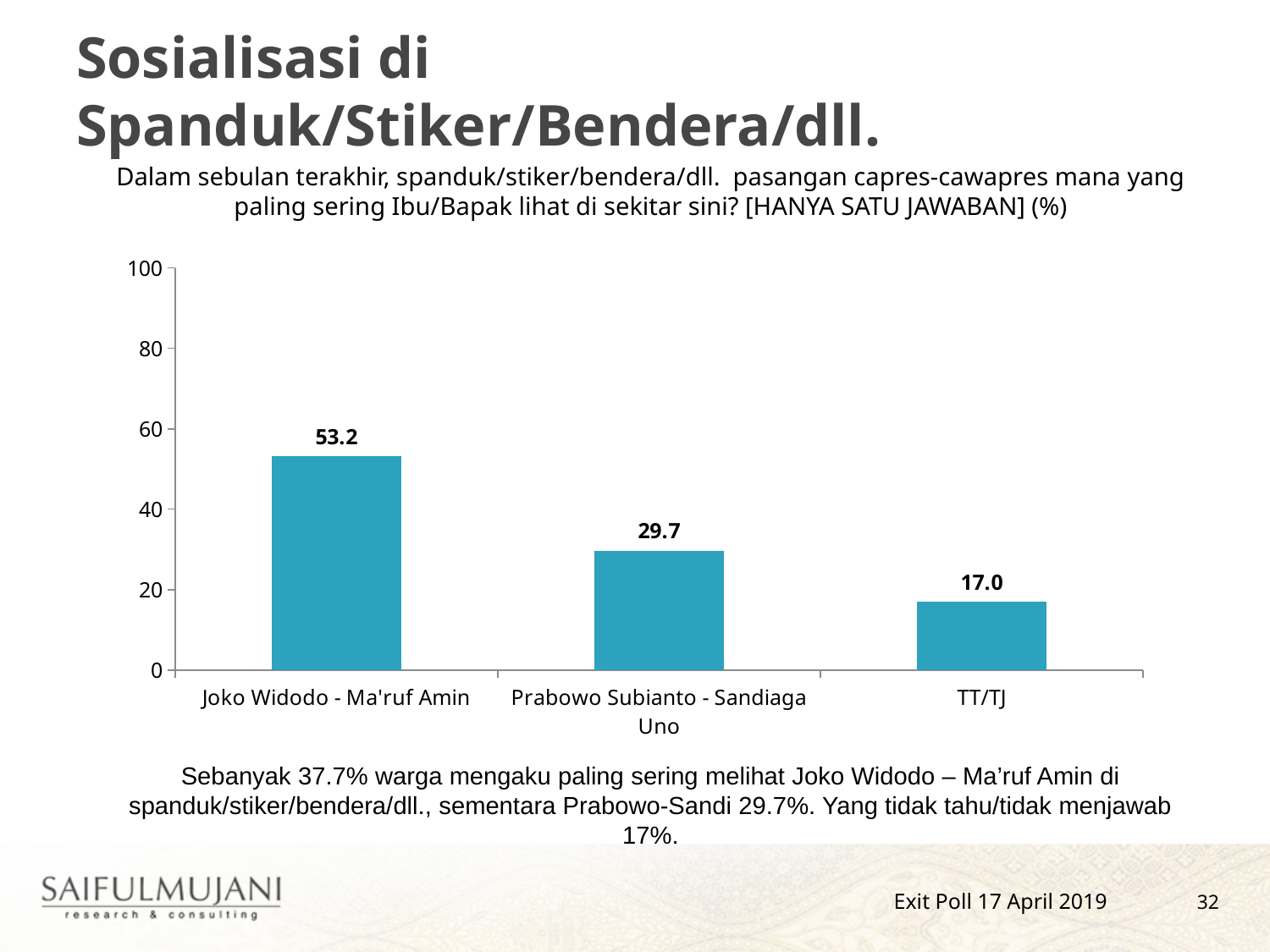
How many categories are shown on the x axis? 3 What is the value for Prabowo Subianto - Sandiaga Uno? 29.7 Is the value for Joko Widodo - Ma'ruf Amin greater or less than 40? greater What kind of chart is shown on the slide? bar chart Which is larger, the value for Prabowo Subianto - Sandiaga Uno or the value for TT/TJ? Prabowo Subianto - Sandiaga Uno What is the value for TT/TJ? 17.0 What is the value for Joko Widodo - Ma'ruf Amin? 53.2 Which category has the lowest value? TT/TJ Do the values rise or fall from left to right along the x axis? fall What is the difference between the values for Prabowo Subianto - Sandiaga Uno and TT/TJ? 12.7 What is the difference between the values for Joko Widodo - Ma'ruf Amin and Prabowo Subianto - Sandiaga Uno? 23.5 Which category has the highest value? Joko Widodo - Ma'ruf Amin